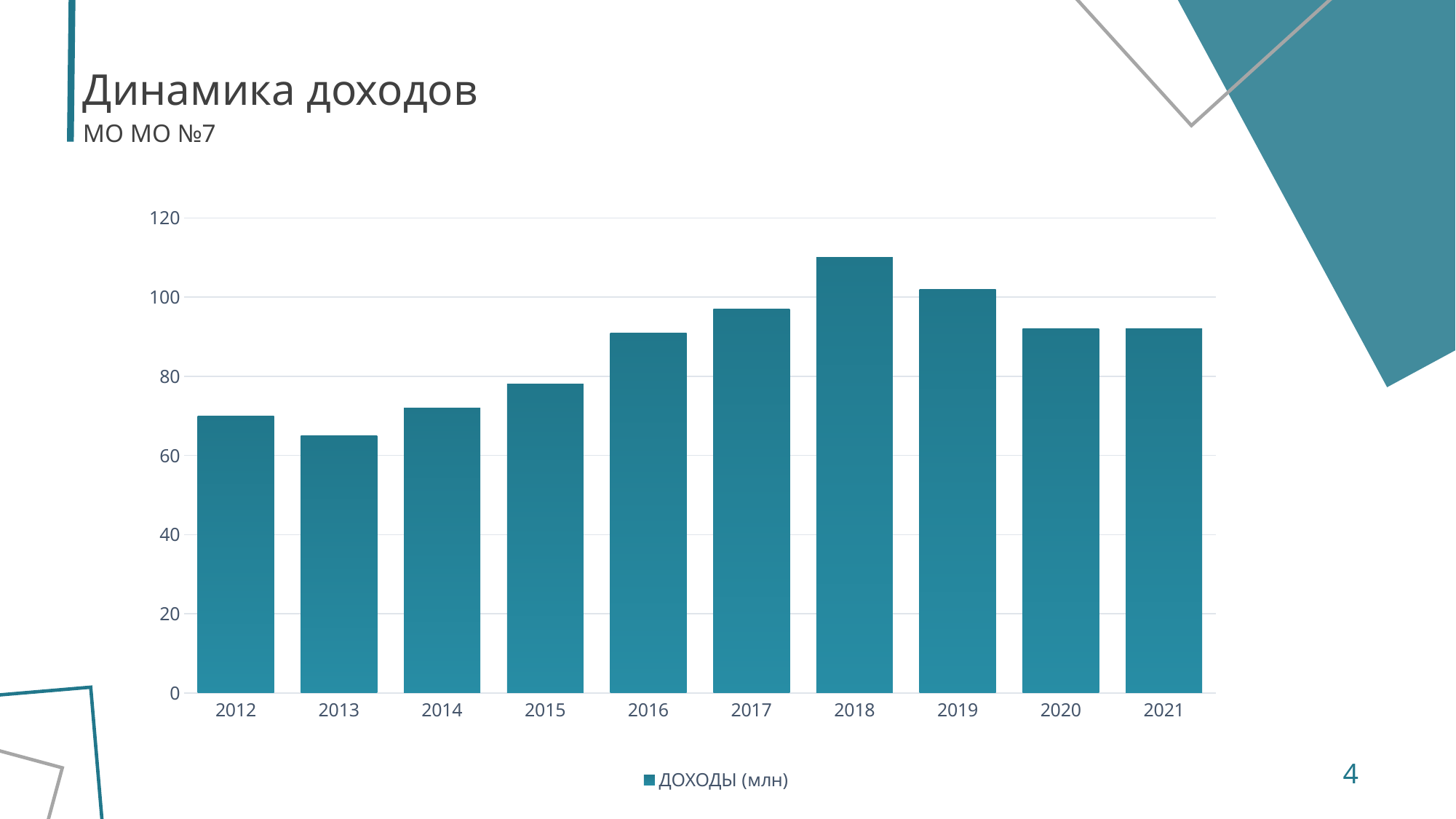
How many years are shown on the x axis of the chart? 10 Is the value for 2018 greater or less than 100? greater How many series does the legend list? 1 What is the legend entry of the series in the chart? ДОХОДЫ (млн) Do the values rise or fall from 2013 to 2018? rise Which is larger, the value for 2017 or the value for 2019? 2019 Is the value for 2016 greater or less than 80? greater Which year has the lowest value in the chart? 2013 Which year has the highest value in the chart? 2018 Is the value for 2013 greater or less than 80? less What kind of chart is shown on the slide? bar chart